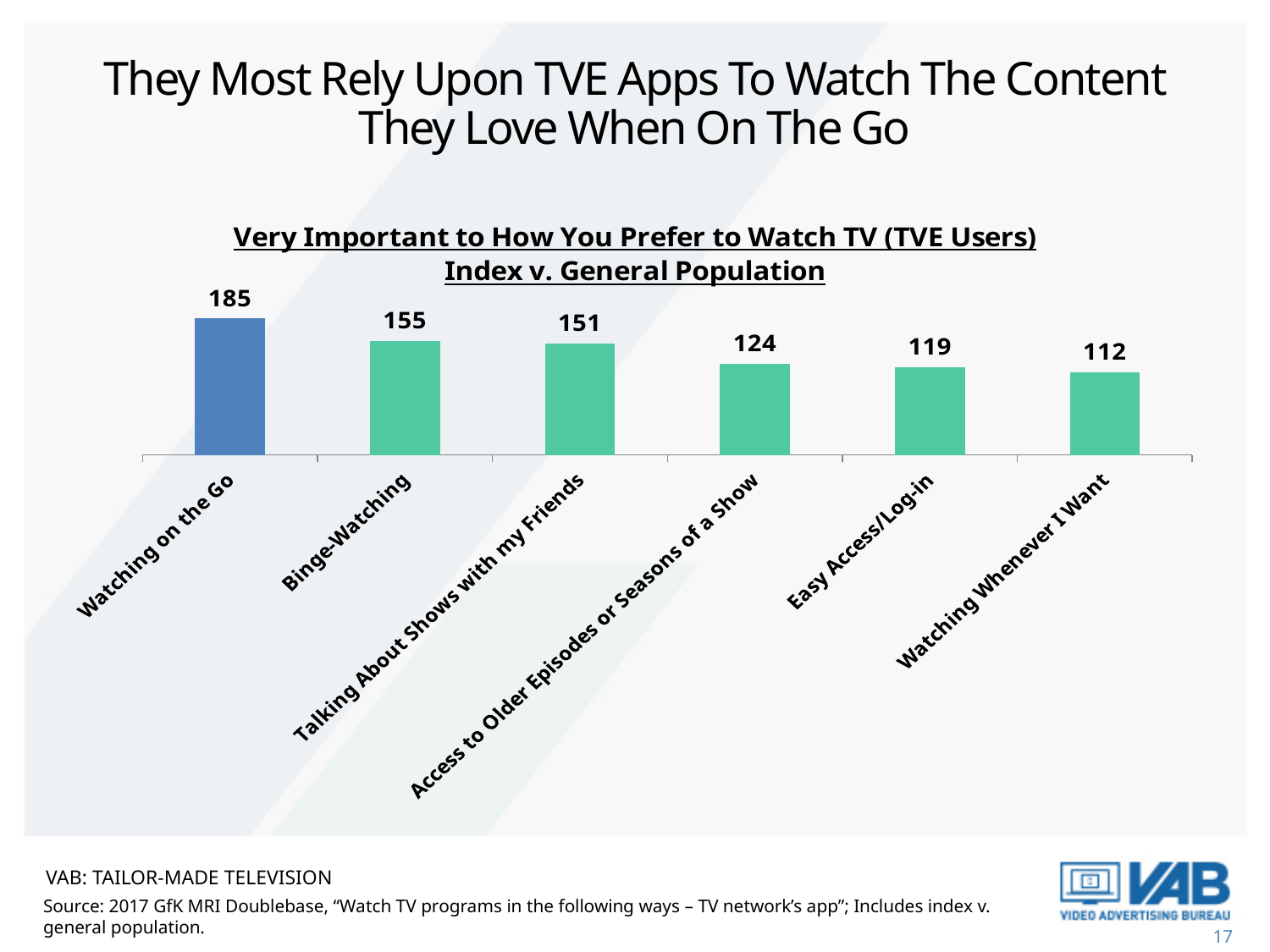
What is the index value for Access to Older Episodes or Seasons of a Show? 124 Which has a higher index value, Binge-Watching or Easy Access/Log-in? Binge-Watching What is the index value for Watching on the Go? 185 What is the difference between the index values for Watching on the Go and Binge-Watching? 30 What kind of chart is shown on the slide? Bar chart Do the index values rise or fall from left to right across the categories? Fall What is the index value for Binge-Watching? 155 Which category has the lowest index value? Watching Whenever I Want What is the difference between the index values for Talking About Shows with my Friends and Watching Whenever I Want? 39 How many categories are shown in the chart? 6 Which category has the highest index value? Watching on the Go What is the index value for Easy Access/Log-in? 119